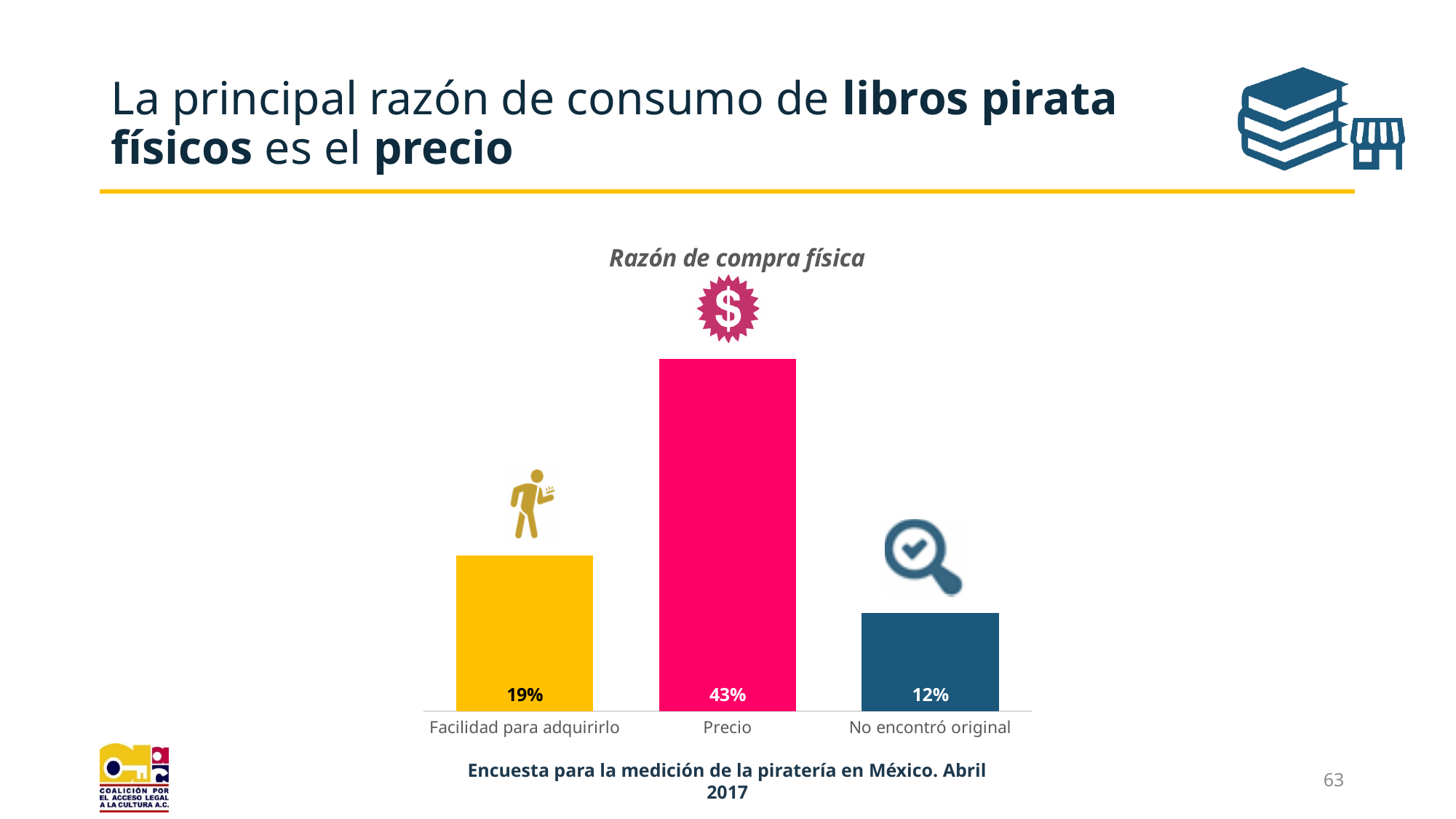
What colour is the bar for Precio? Pink What is the value for No encontró original? 12% How many categories are shown in the chart? 3 What is the value for Precio? 43% What is the difference between the values for Facilidad para adquirirlo and No encontró original? 7% What is the difference between the values for Precio and Facilidad para adquirirlo? 24% Which category has the highest value? Precio Which is larger, the value for Facilidad para adquirirlo or the value for No encontró original? Facilidad para adquirirlo Which category has the lowest value? No encontró original What is the value for Facilidad para adquirirlo? 19% What kind of chart is shown on the slide? Bar chart What is the title of the chart? Razón de compra física